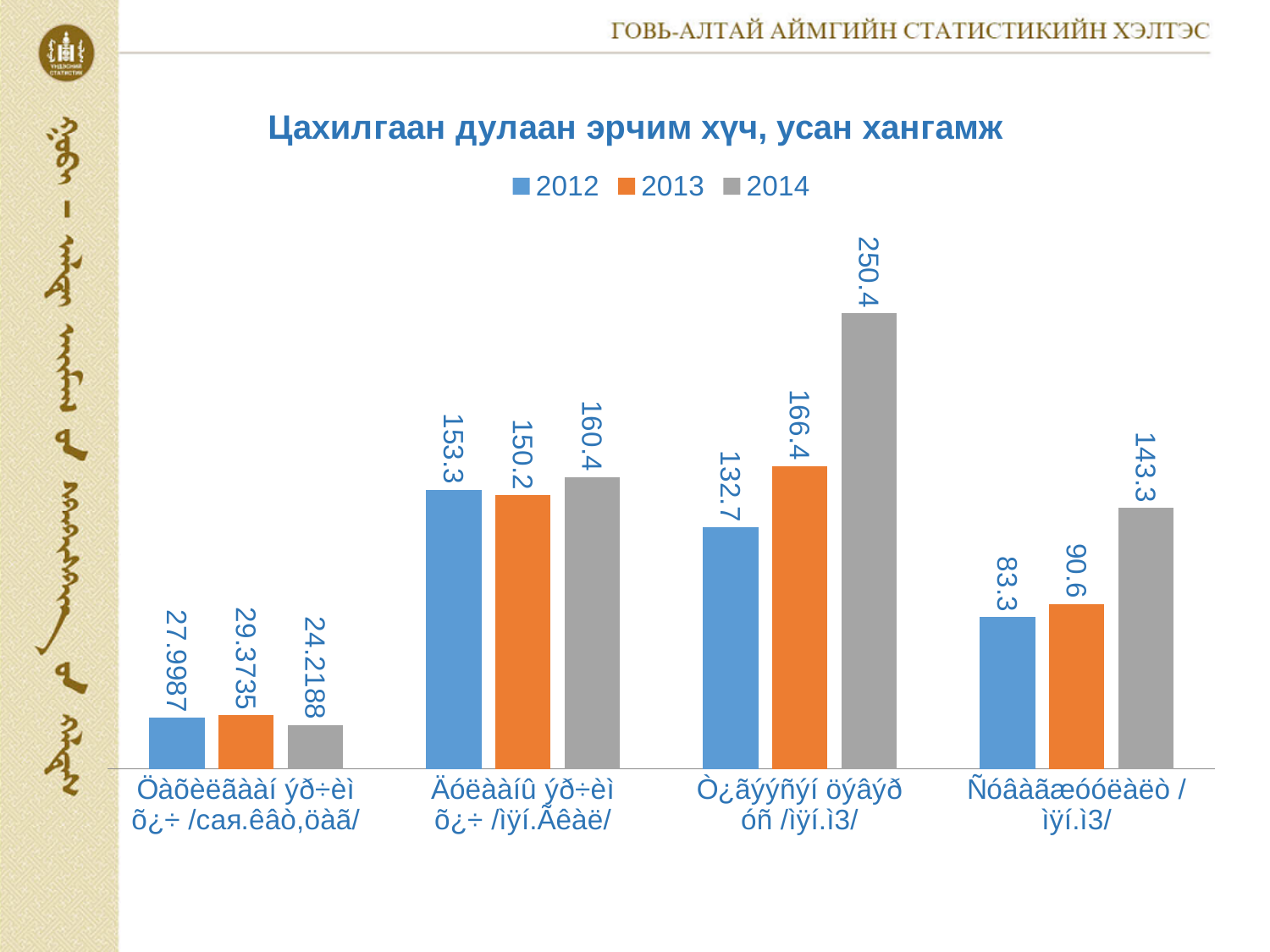
What is the 2012 value for the second category from the left? 153.3 What is the 2013 value for the fourth (rightmost) category? 90.6 What is the title of the chart? Цахилгаан дулаан эрчим хүч, усан хангамж In the first (leftmost) category, which year has the lowest value? 2014 In the third category from the left, what is the difference between the 2014 and 2013 values? 84.0 How many categories are shown along the x axis? 4 What is the 2014 value for the third category from the left? 250.4 In the second category from the left, which is larger: the 2012 value or the 2013 value? 2012 What kind of chart is shown on the slide? bar chart In the fourth (rightmost) category, which year has the highest value? 2014 In the fourth (rightmost) category, do the values rise or fall from 2012 to 2014? rise How many series does the legend list? 3